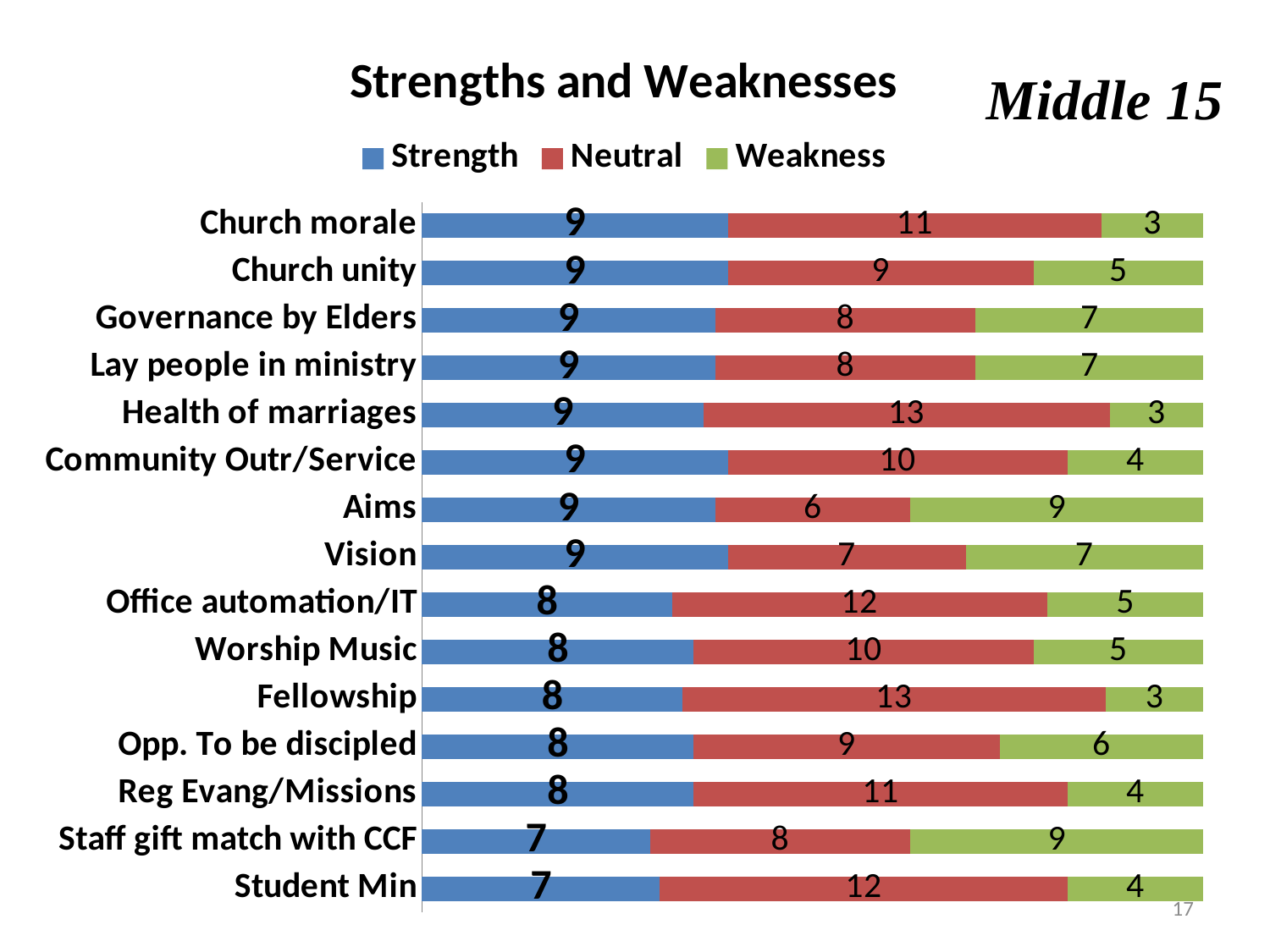
How many series does the legend list? 3 What is the Strength value for Student Min? 7 What is the total of the Strength, Neutral and Weakness values for Fellowship? 24 What kind of chart is shown on the slide? Stacked bar chart What is the Weakness value for Aims? 9 For Church morale, what is the difference between the Neutral value and the Weakness value? 8 Which has the larger Neutral value, Fellowship or Worship Music? Fellowship How many categories are shown on the chart? 15 What is the Neutral value for Office automation/IT? 12 What is the Neutral value for Health of marriages? 13 What is the Weakness value for Reg Evang/Missions? 4 Which has the larger Weakness value, Governance by Elders or Church unity? Governance by Elders